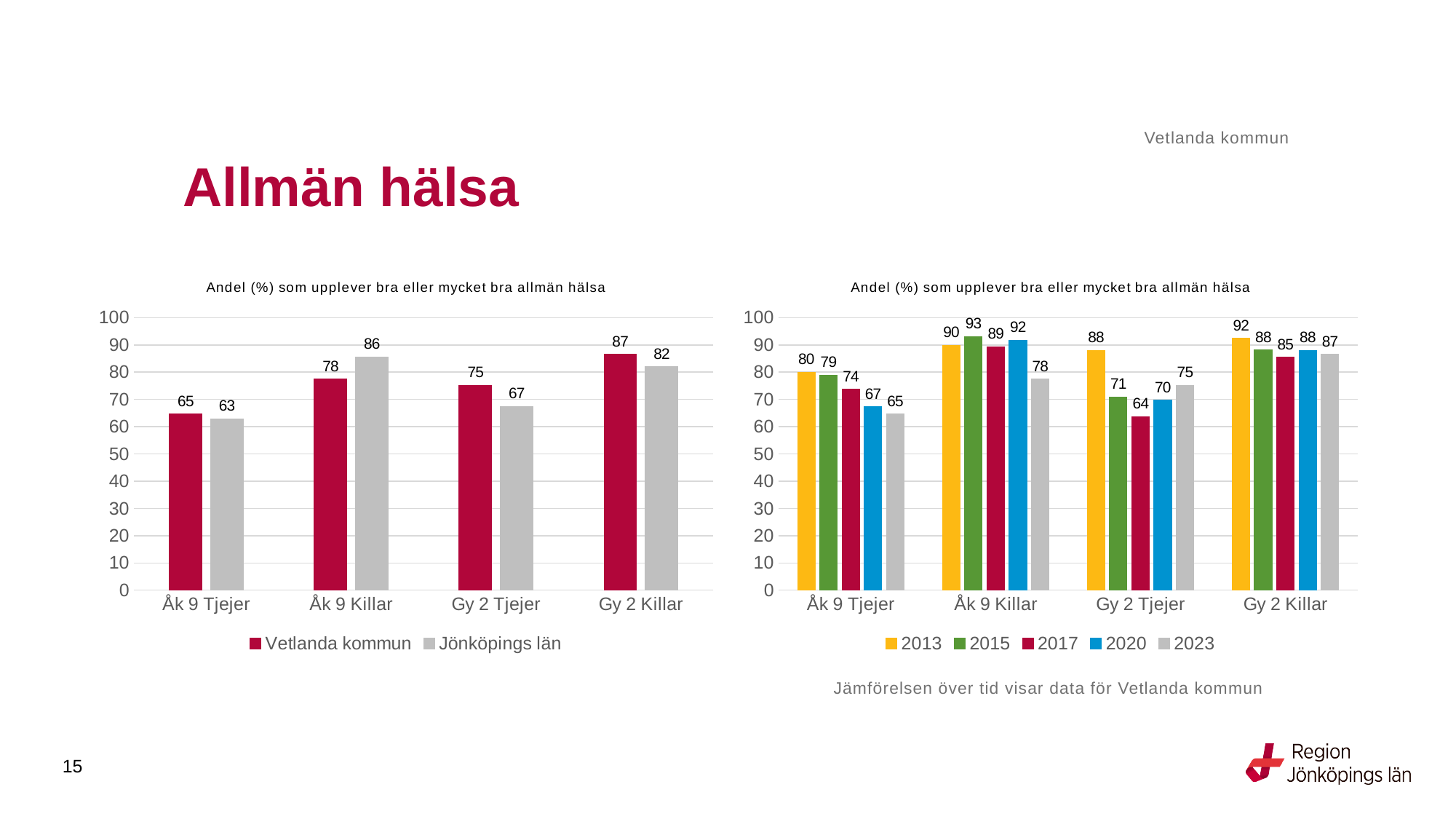
How many series does the legend of the left chart list? 2 In the right chart, do the values for Åk 9 Tjejer rise or fall from 2013 to 2023? fall In the left chart, which category has the highest value for Vetlanda kommun? Gy 2 Killar In the left chart, what is the difference between Jönköpings län and Vetlanda kommun for Åk 9 Killar? 8 In the right chart, what is the value for 2017 for Gy 2 Tjejer? 64 In the left chart, what is the value for Vetlanda kommun for Åk 9 Killar? 78 In the left chart, which is larger for Gy 2 Tjejer: Vetlanda kommun or Jönköpings län? Vetlanda kommun In the right chart, what is the difference between 2013 and 2023 for Åk 9 Tjejer? 15 In the right chart, which year has the lowest value for Åk 9 Tjejer? 2023 In the right chart, what is the value for 2023 for Åk 9 Killar? 78 What kind of chart is the right chart? bar chart In the left chart, what is the value for Jönköpings län for Gy 2 Tjejer? 67